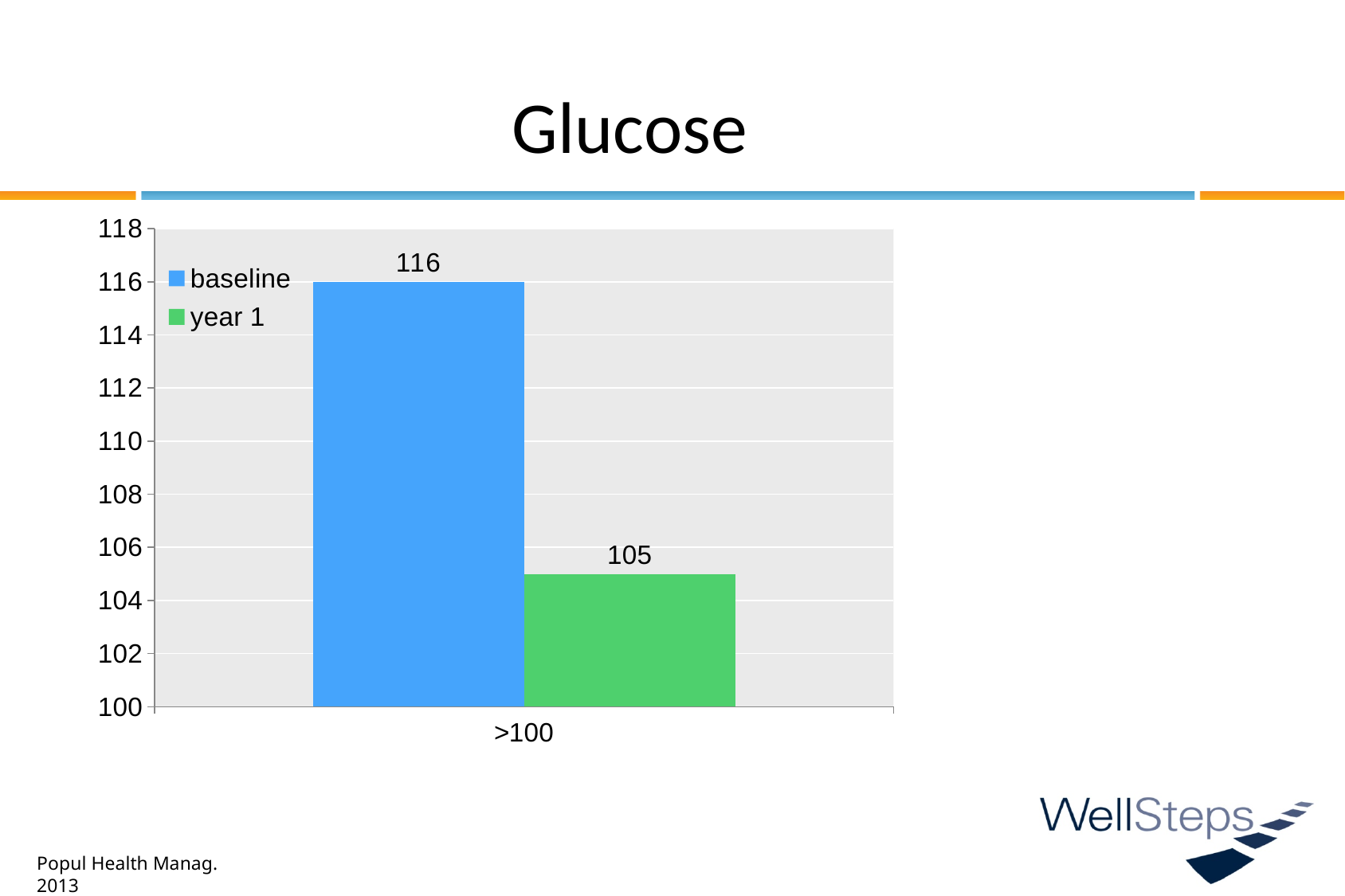
Is the baseline value for the >100 category greater or less than 110? greater Which series has the higher value for the >100 category, baseline or year 1? baseline What kind of chart is shown on the slide? bar chart What colour represents the year 1 series in the chart? green How many categories are shown on the x axis? 1 Is the year 1 value for the >100 category greater or less than 110? less Which series has the lowest value in the chart? year 1 What is the difference between the baseline and year 1 values for the >100 category? 11 What is the year 1 value for the >100 category? 105 What is the title of the slide containing the chart? Glucose What is the baseline value for the >100 category? 116 How many series does the legend list? 2